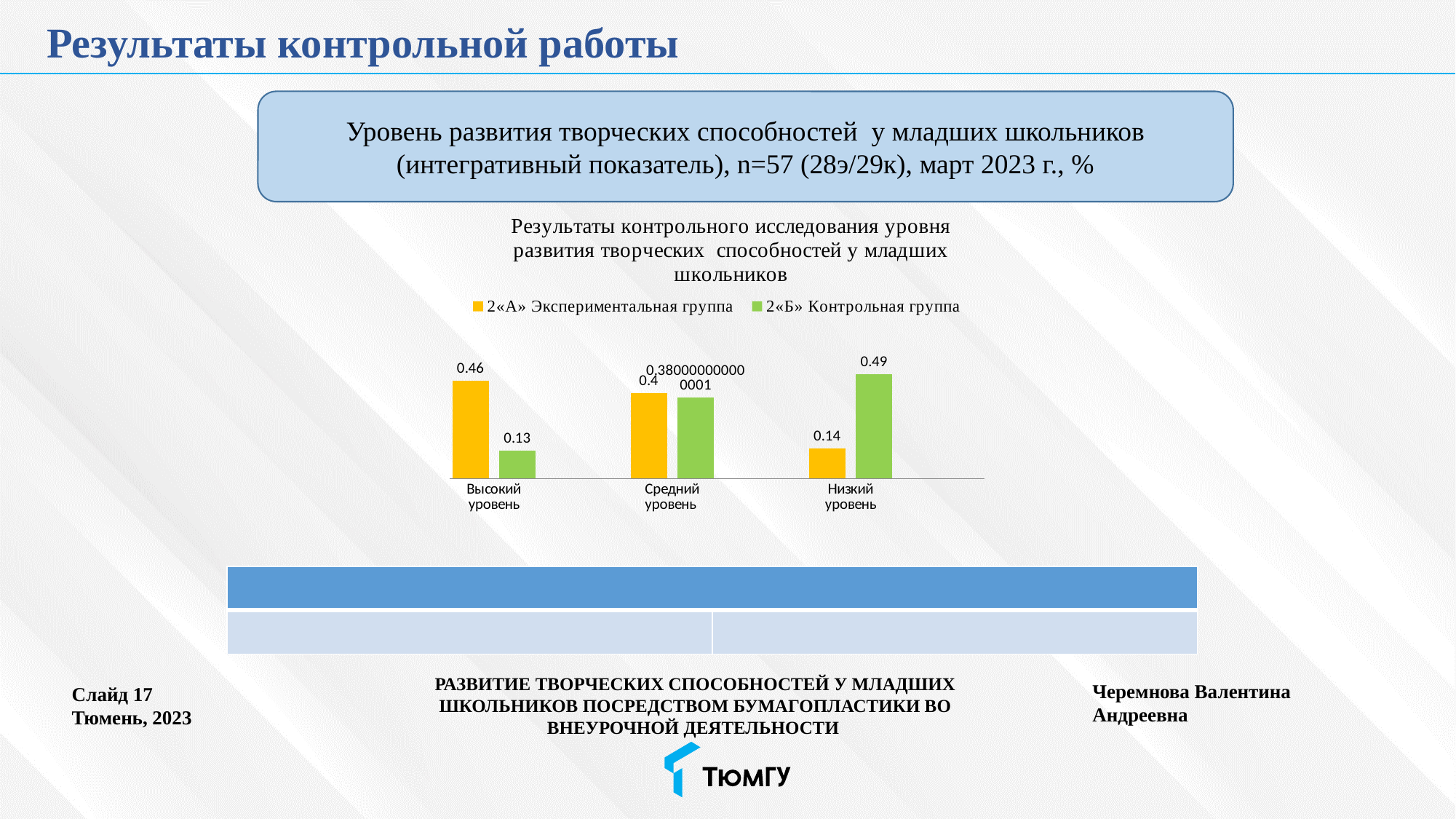
What is the value for 2«А» Экспериментальная группа at Низкий уровень? 0.14 What kind of chart is shown on the slide? Bar chart How many categories are shown on the x axis? 3 Which category has the lowest value for 2«А» Экспериментальная группа? Низкий уровень Which category has the highest value for 2«Б» Контрольная группа? Низкий уровень What is the value for 2«Б» Контрольная группа at Низкий уровень? 0.49 At Низкий уровень, which series has the larger value? 2«Б» Контрольная группа What is the value for 2«А» Экспериментальная группа at Средний уровень? 0.4 How many series does the legend list? 2 What is the value for 2«А» Экспериментальная группа at Высокий уровень? 0.46 What is the value for 2«Б» Контрольная группа at Высокий уровень? 0.13 What is the difference between the 2«А» Экспериментальная группа and 2«Б» Контрольная группа values at Высокий уровень? 0.33